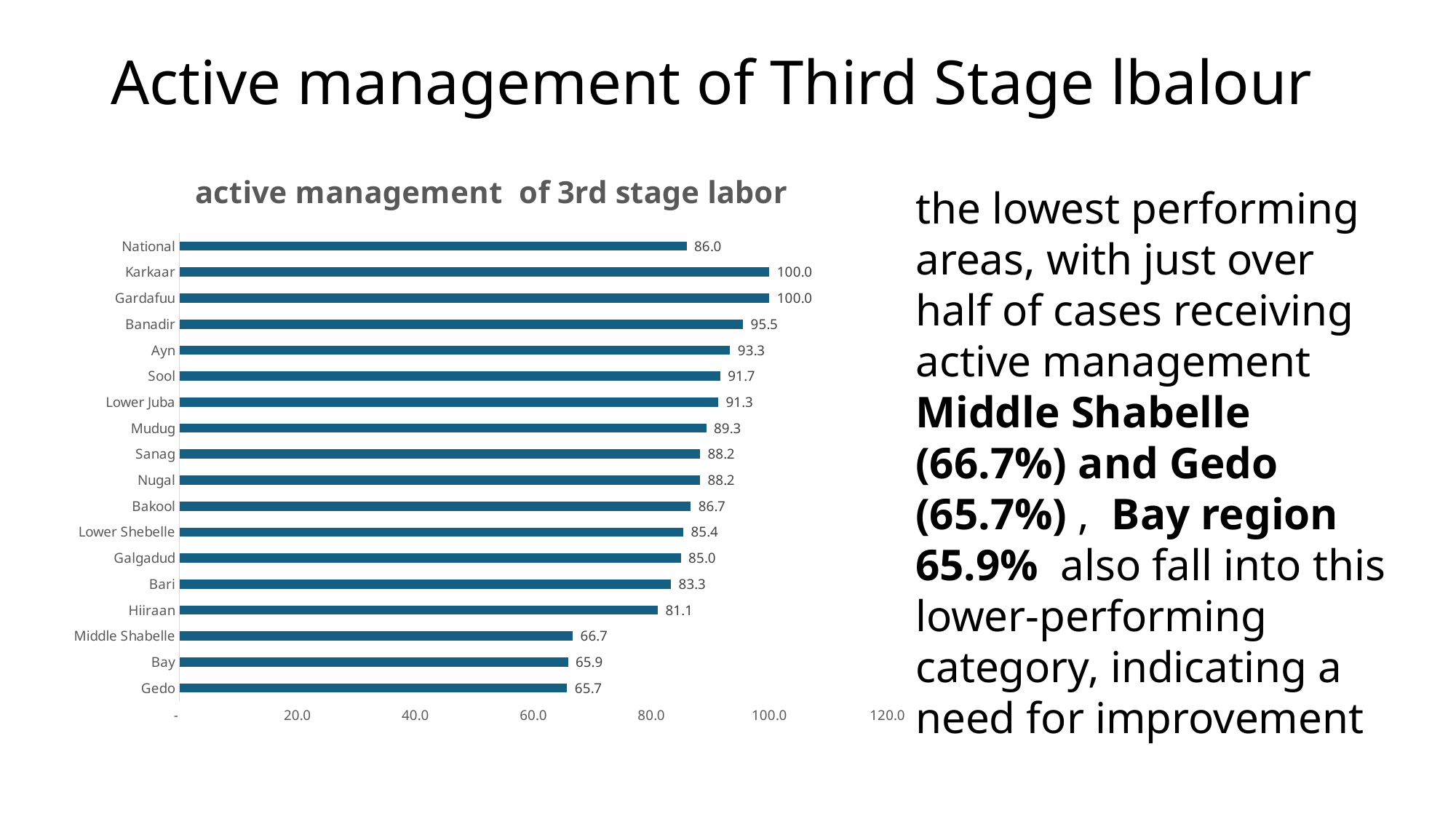
What is the value for Middle Shabelle? 66.7 Which category has the lowest value? Gedo What kind of chart is shown on the slide? bar chart What is the difference between the values for Karkaar and Gedo? 34.3 What is the value for Lower Juba? 91.3 Which two categories share the highest value of 100.0? Karkaar and Gardafuu What is the title of the chart? active management of 3rd stage labor Which is larger, the value for Sool or the value for Bari? Sool What is the value for National? 86.0 Is the value for Bay greater or less than 80.0? less What is the difference between the values for Banadir and Hiiraan? 14.4 How many categories are shown on the chart? 18